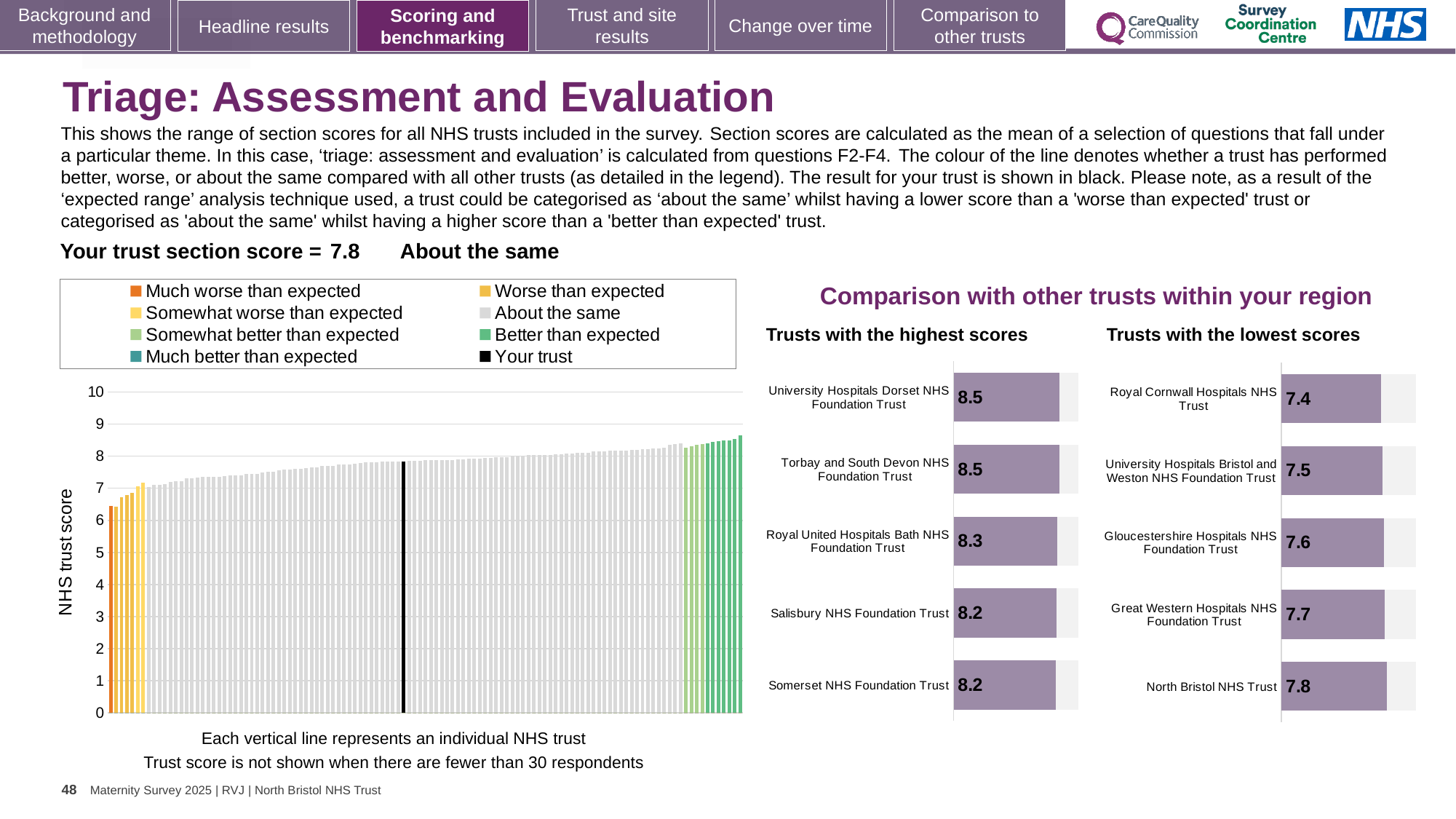
In the 'Trusts with the lowest scores' chart, which trust has the lowest score? Royal Cornwall Hospitals NHS Trust In the 'Trusts with the lowest scores' chart, what is the difference between the scores of North Bristol NHS Trust and Royal Cornwall Hospitals NHS Trust? 0.4 In the 'Trusts with the lowest scores' chart, what is the score for Gloucestershire Hospitals NHS Foundation Trust? 7.6 How many entries does the legend of the NHS trust score chart on the left list? 8 In the NHS trust score chart on the left, what colour is the bar representing your trust? Black What kind of chart is the 'Trusts with the lowest scores' chart? Bar chart In the NHS trust score chart on the left, do the bar values rise or fall from left to right? Rise In the 'Trusts with the lowest scores' chart, which trust has the highest score? North Bristol NHS Trust How many trusts are shown in the 'Trusts with the highest scores' chart? 5 In the 'Trusts with the highest scores' chart, which has the larger score: Salisbury NHS Foundation Trust or Royal United Hospitals Bath NHS Foundation Trust? Royal United Hospitals Bath NHS Foundation Trust In the NHS trust score chart on the left, is the value of the leftmost bar greater or less than 7? less In the 'Trusts with the highest scores' chart, what is the score for Royal United Hospitals Bath NHS Foundation Trust? 8.3